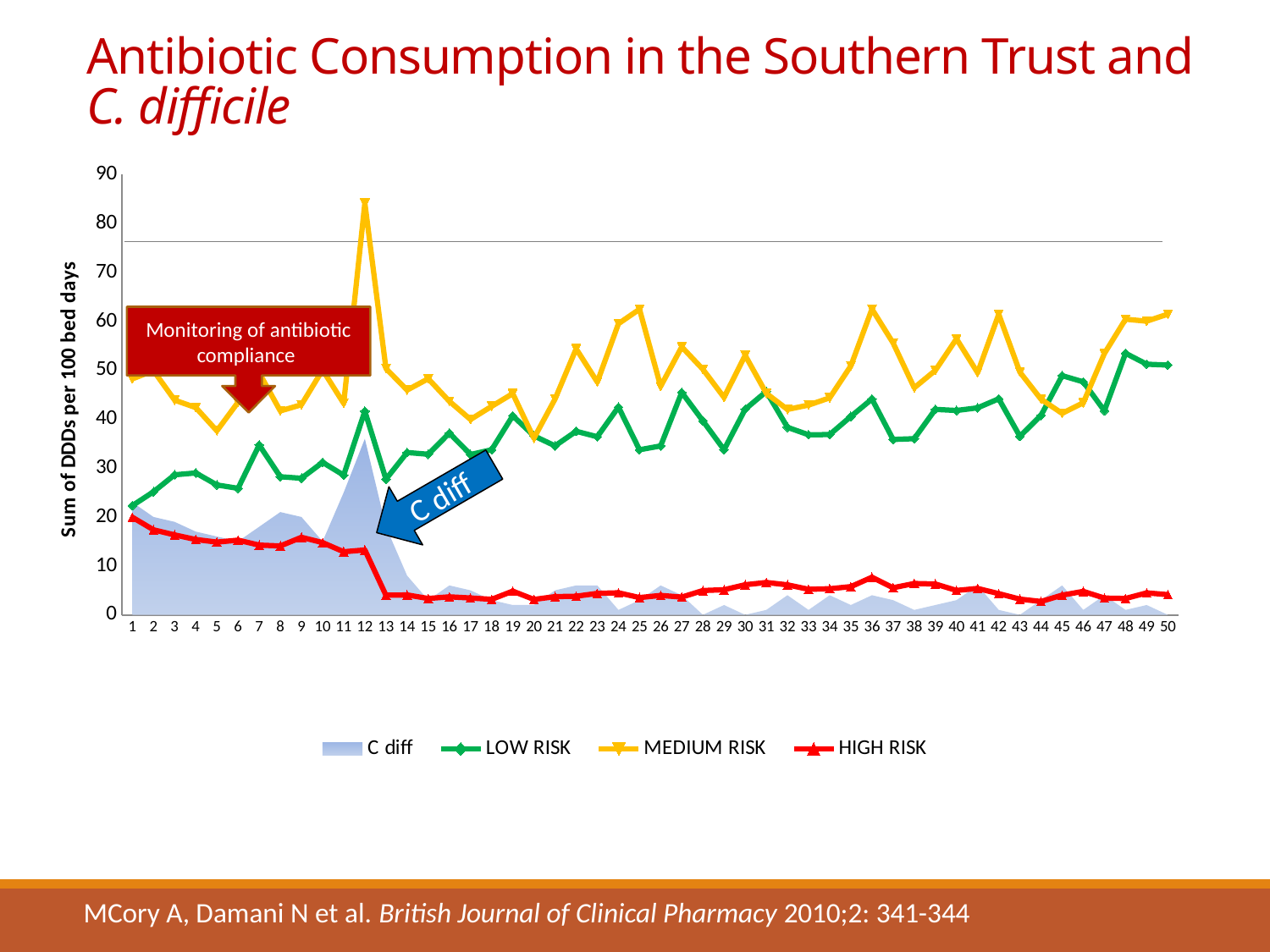
How many points are on the x axis of the chart? 50 What kind of chart is shown on the slide? Combination area and line chart Does the HIGH RISK series rise or fall from point 1 to point 50? fall At point 30, which is larger: LOW RISK or HIGH RISK? LOW RISK Which series reaches the highest value on the chart? MEDIUM RISK How many series does the legend list? 4 At which x-axis point does the MEDIUM RISK series reach its peak? 12 Is the HIGH RISK value at point 1 greater or less than 10? greater Is the HIGH RISK value at point 20 greater or less than 10? less What is the label on the y axis of the chart? Sum of DDDs per 100 bed days Is the MEDIUM RISK value at point 12 greater or less than 80? greater